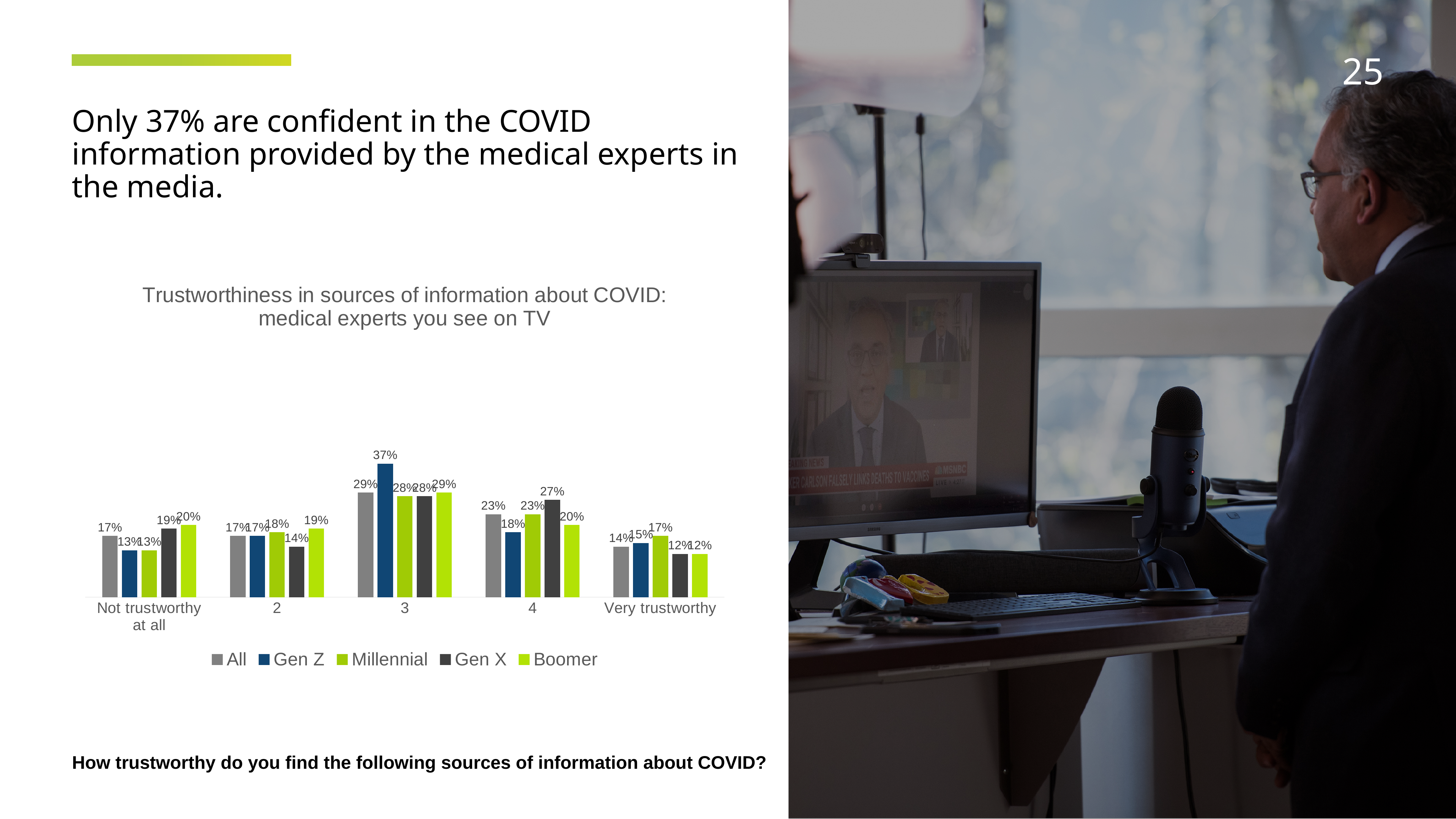
How many categories are shown along the x axis? 5 What is the value for Boomer in the "2" category? 19% In the "Not trustworthy at all" category, which is larger: Gen X or Boomer? Boomer What is the title of the chart? Trustworthiness in sources of information about COVID: medical experts you see on TV What is the difference between the Gen Z and All values in the "3" category? 8 percentage points Which series has the highest value in the "3" category? Gen Z Which series has the lowest value in the "2" category? Gen X What is the value for All in the "Very trustworthy" category? 14% What kind of chart is shown on the slide? bar chart What is the value for Gen X in the "4" category? 27% What is the value for Gen Z in the "3" category? 37% How many series does the legend list? 5